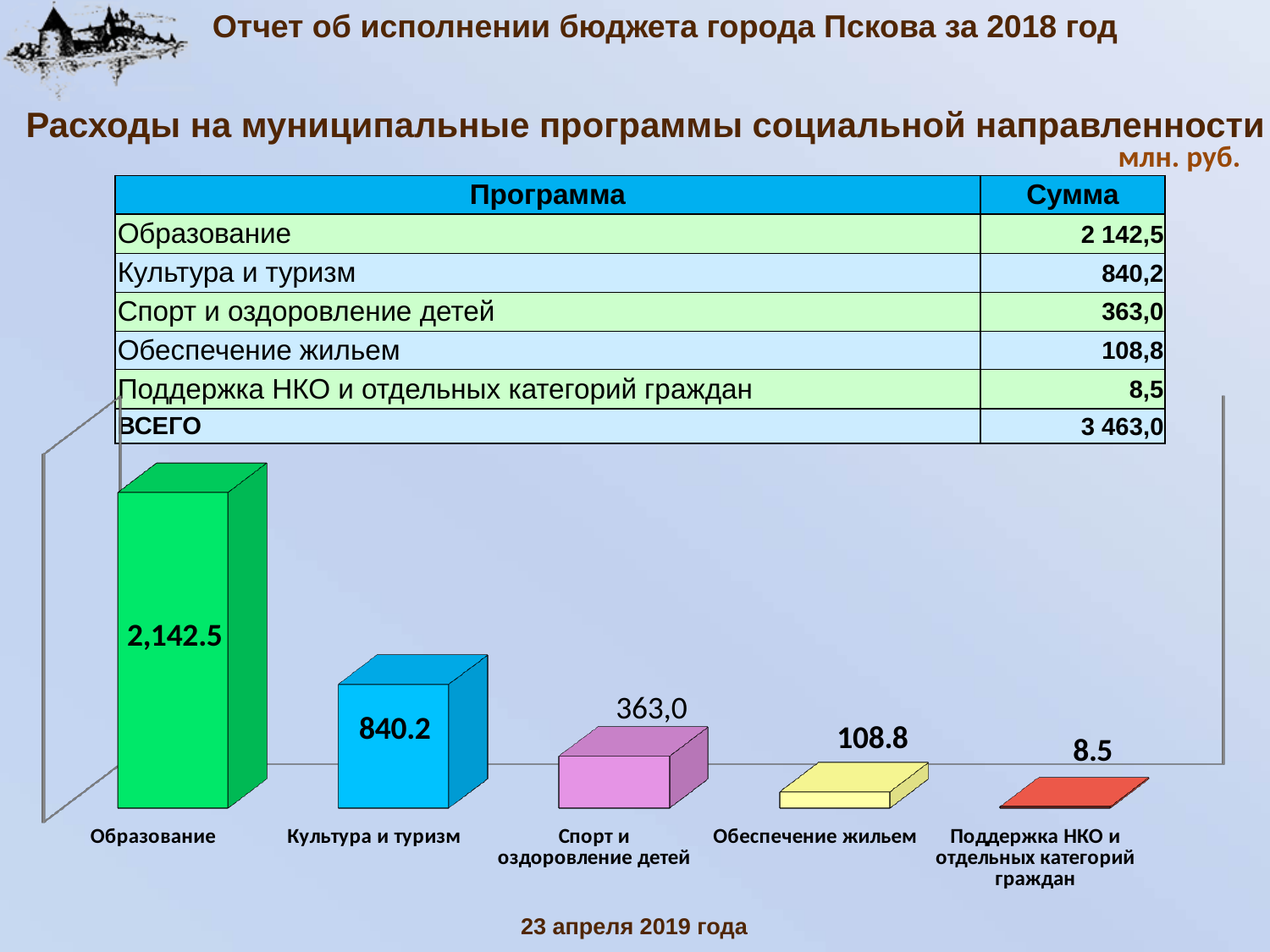
What is the difference between the values for Образование and Культура и туризм? 1,302.3 Which category has the lowest value on the chart? Поддержка НКО и отдельных категорий граждан What is the value for Поддержка НКО и отдельных категорий граждан on the chart? 8.5 What is the value for Обеспечение жильем on the chart? 108.8 What kind of chart is shown on the slide? Bar chart How many categories are shown on the chart? 5 Do the values rise or fall from left to right along the x axis? Fall What is the value for Образование on the chart? 2,142.5 Which category has the highest value on the chart? Образование Which is larger: the value for Культура и туризм or the value for Спорт и оздоровление детей? Культура и туризм What is the value for Спорт и оздоровление детей on the chart? 363,0 What is the value for Культура и туризм on the chart? 840.2